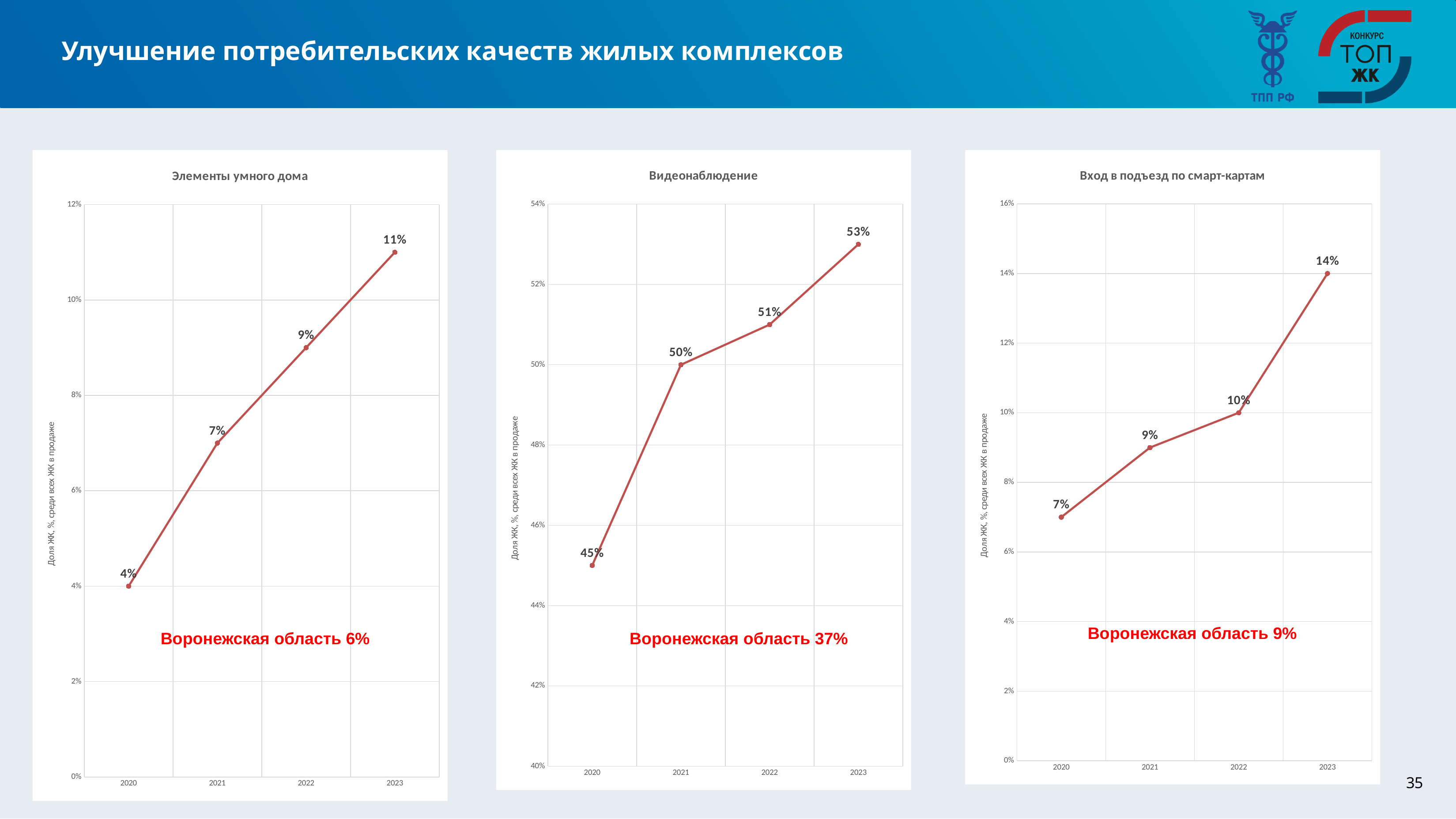
In the chart titled "Видеонаблюдение", what is the value for 2020? 45% In the chart titled "Вход в подъезд по смарт-картам", what is the difference between the values for 2023 and 2020? 7% How many data points are plotted in the chart titled "Видеонаблюдение"? 4 In the chart titled "Видеонаблюдение", which year has the highest value? 2023 In the chart titled "Видеонаблюдение", what is the difference between the values for 2021 and 2020? 5% In the chart titled "Вход в подъезд по смарт-картам", do the values rise or fall from 2020 to 2023? rise In the chart titled "Вход в подъезд по смарт-картам", what is the value for 2022? 10% In the chart titled "Элементы умного дома", which year has the lowest value? 2020 What kind of chart is the chart titled "Элементы умного дома"? line chart In the chart titled "Вход в подъезд по смарт-картам", is the value for 2023 greater or less than 12%? greater In the chart titled "Элементы умного дома", what is the value for 2023? 11% In the chart titled "Элементы умного дома", which is larger: the value for 2021 or the value for 2022? 2022